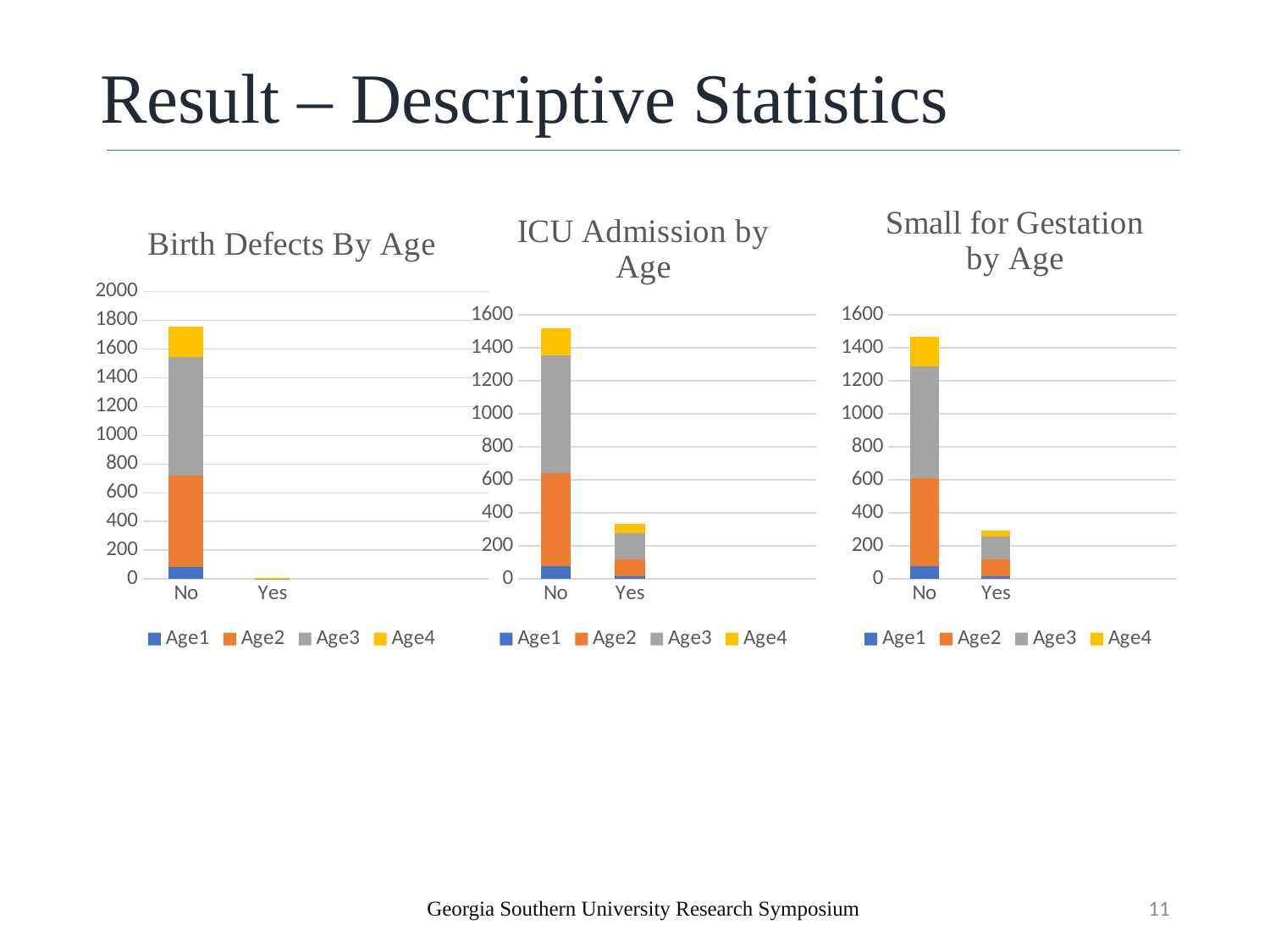
In the Birth Defects By Age chart, what is the highest value shown on the vertical axis? 2000 In the Small for Gestation by Age chart, how many categories are shown on the x axis? 2 In the Small for Gestation by Age chart, is the total for Yes greater or less than 400? less In the Birth Defects By Age chart, which category has the taller stacked bar? No In the ICU Admission by Age chart, which category has the shorter stacked bar? Yes In the ICU Admission by Age chart, how many series does the legend list? 4 In the Small for Gestation by Age chart, which colour represents Age4 in the legend? yellow In the ICU Admission by Age chart, which is larger for the No bar: the Age2 segment or the Age1 segment? Age2 In the Birth Defects By Age chart, is the total for No greater or less than 1600? greater In the ICU Admission by Age chart, is the total for Yes greater or less than 400? less In the Birth Defects By Age chart, what kind of chart is shown? stacked bar chart